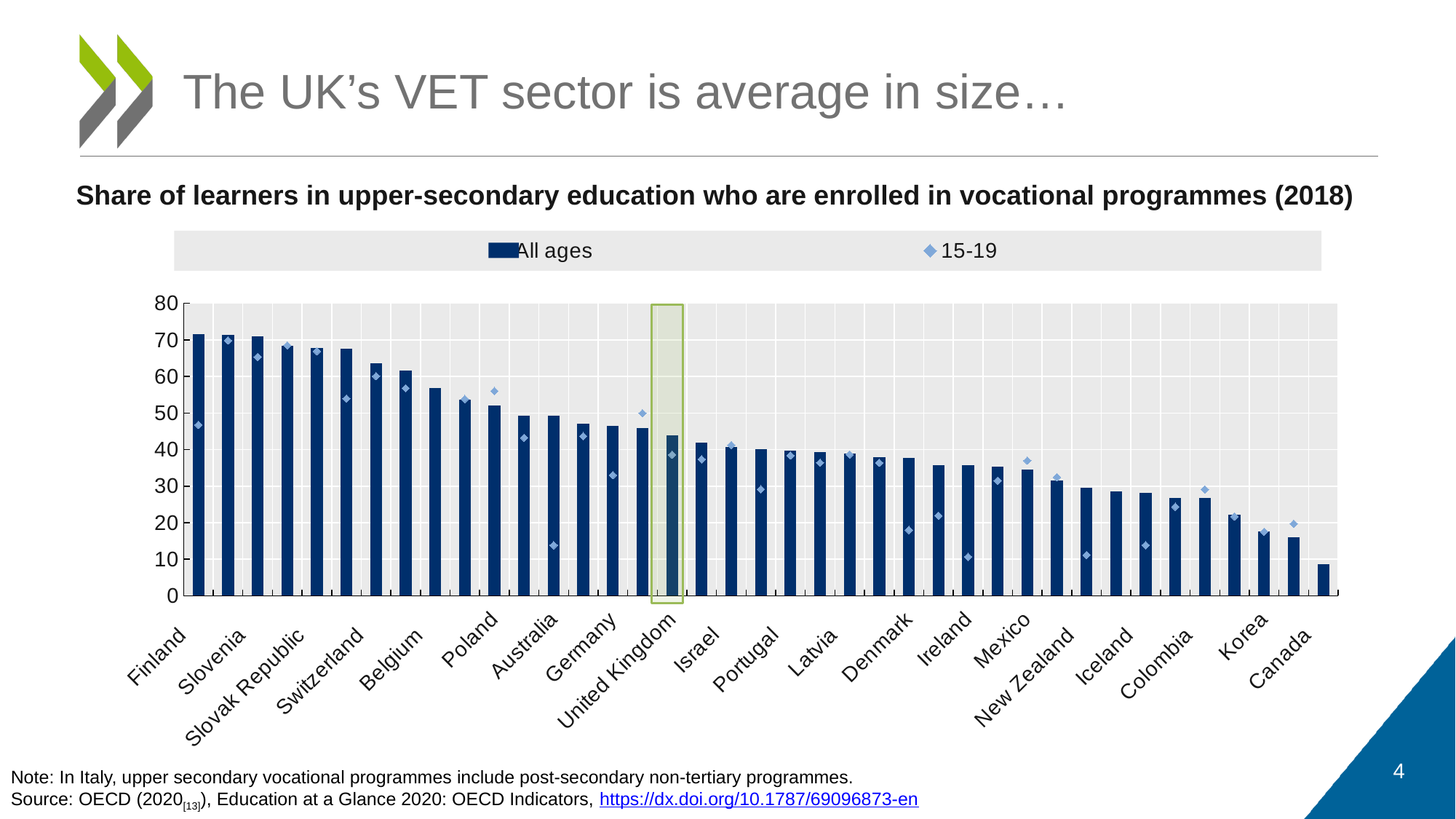
Do the All ages values rise or fall moving from left to right along the x axis? fall Which country is highlighted with a green box on the chart? United Kingdom What are the two series named in the legend? All ages and 15-19 Is the All ages value for Korea greater or less than 20? less Is the All ages value for the United Kingdom greater or less than 40? greater Which country has the lowest All ages value? Canada How many series does the legend list? 2 For Germany, which is larger: the All ages value or the 15-19 value? All ages Is the All ages value for Finland greater or less than 60? greater What kind of chart is shown on the slide? bar chart (with a marker series) Which has the larger All ages value, Finland or Canada? Finland